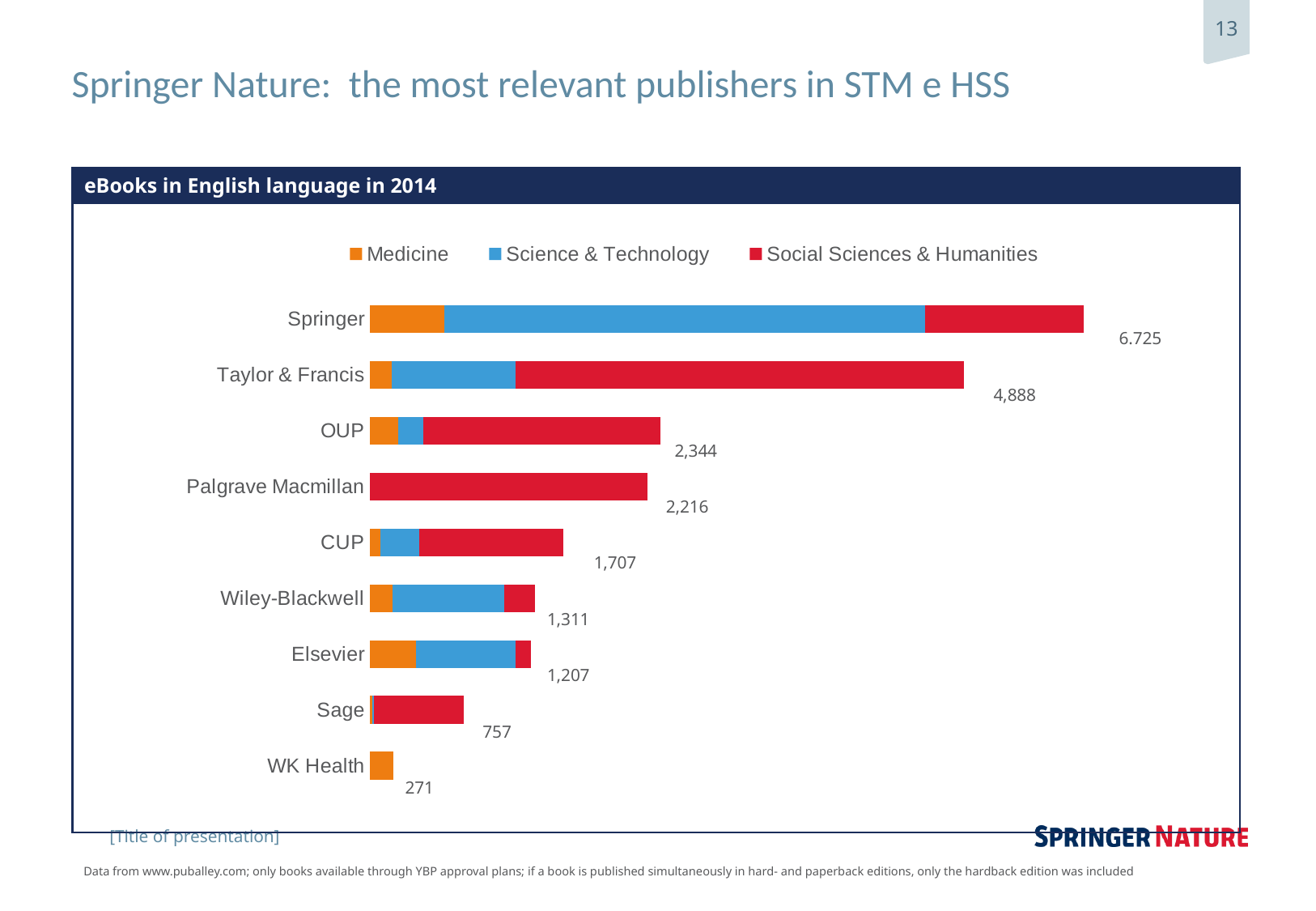
What is the total value labelled for Springer? 6.725 What is the total value labelled for OUP? 2,344 What kind of chart is shown on the slide? Stacked bar chart Which publisher has the lowest total number of eBooks? WK Health Which has a larger total, Palgrave Macmillan or CUP? Palgrave Macmillan What is the difference between the totals for Wiley-Blackwell and Elsevier? 104 How many series does the legend list? 3 What is the total value labelled for WK Health? 271 What is the difference between the totals for Taylor & Francis and OUP? 2,544 Which publisher has the highest total number of eBooks? Springer How many publishers are shown in the chart? 9 What is the total number of eBooks shown for Taylor & Francis? 4,888